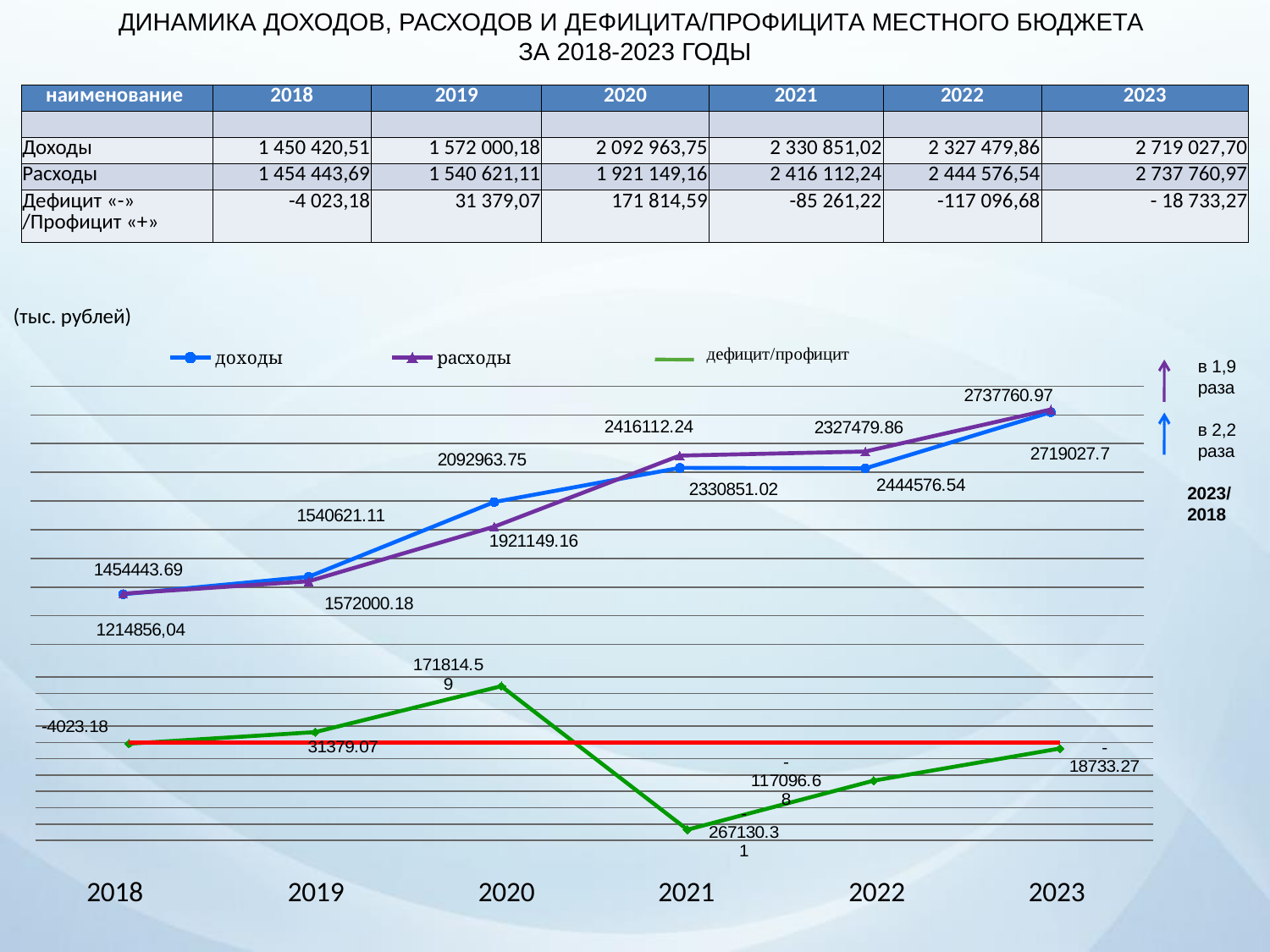
How many series does the chart legend list? 3 In which year does the расходы series reach its highest value on the chart? 2023 How many years are plotted along the x axis of the chart? 6 Which colour is used for the доходы series on the chart? blue What is the value of расходы for 2023 on the chart? 2737760.97 Which is larger in 2021 on the chart, доходы or расходы? расходы In which year does the дефицит/профицит series reach its highest value on the chart? 2020 What kind of chart is shown on the slide? line chart What is the value of расходы for 2021 on the chart? 2416112.24 Does the расходы series generally rise or fall from 2018 to 2023 on the chart? rise What is the value of дефицит/профицит for 2019 on the chart? 31379.07 What is the value of доходы for 2020 on the chart? 2092963.75